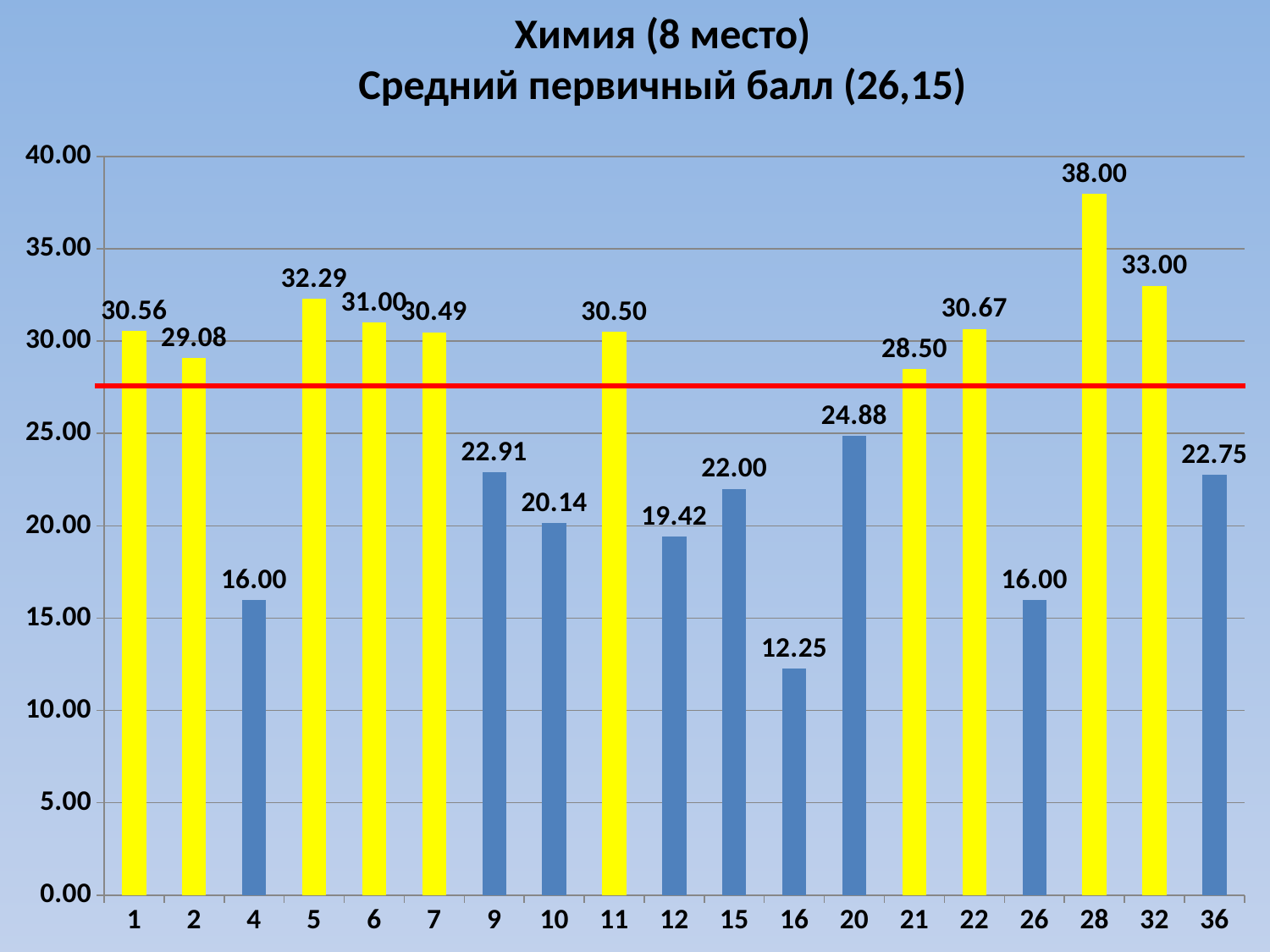
What is the value for category 28? 38.00 What is the title of the chart? Химия (8 место) Средний первичный балл (26,15) How many categories are shown on the x axis? 19 Which category has the highest value? 28 What is the difference between the values for categories 28 and 32? 5.00 Which has the larger value, category 5 or category 6? 5 What is the difference between the values for categories 9 and 10? 2.77 Which category has the lowest value? 16 What kind of chart is shown on the slide? bar chart What is the value for category 21? 28.50 Is the value for category 20 greater or less than 25.00? less What is the value for category 16? 12.25